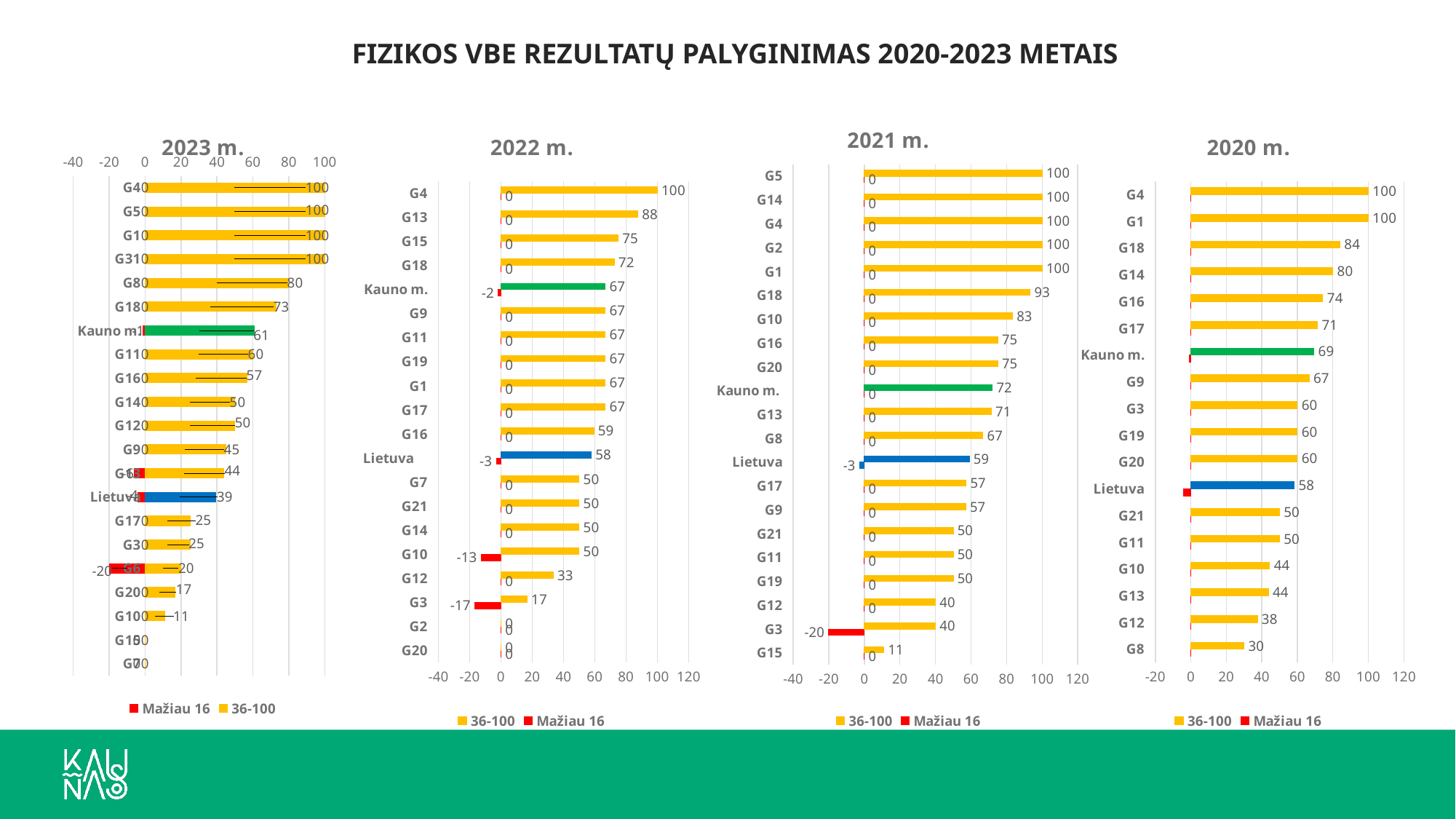
In the 2020 m. chart, what is the difference between the 36-100 values of Kauno m. and Lietuva? 11 In the 2020 m. chart, which category has the lowest 36-100 value? G8 In the 2021 m. chart, which category has the lowest 36-100 value? G15 In the 2021 m. chart, which has the larger 36-100 value, G18 or G10? G18 In the 2022 m. chart, what is the Mažiau 16 value for G10? -13 In the 2023 m. chart, what is the 36-100 value for Kauno m.? 61 How many series does the legend of the 2022 m. chart list? 2 In the 2020 m. chart, what is the 36-100 value for G18? 84 What type of chart is the 2020 m. chart? Bar chart In the 2022 m. chart, what is the 36-100 value for Kauno m.? 67 In the 2021 m. chart, what is the 36-100 value for Lietuva? 59 In the 2022 m. chart, what is the difference between the 36-100 values of G4 and G13? 12